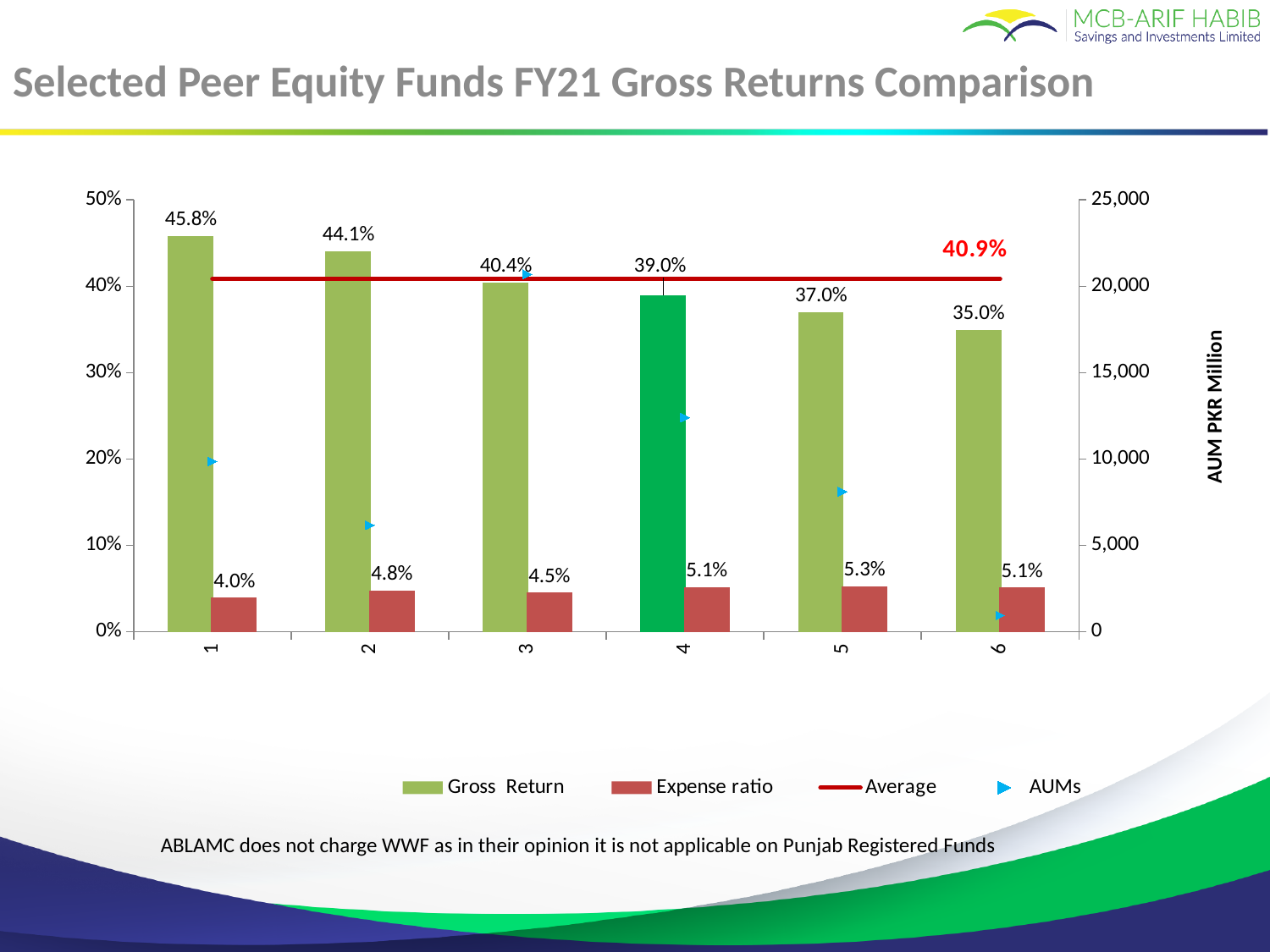
What is the difference between the Gross Return of fund 1 and fund 6? 10.8% How many funds are shown on the x axis? 6 Is the AUMs value for fund 3 greater or less than 15,000? greater Which is larger, the Expense ratio of fund 2 or fund 3? fund 2 Which fund has the lowest Expense ratio? 1 Do the Gross Return values rise or fall from fund 1 to fund 6? fall What is the Expense ratio for fund 5? 5.3% What value does the Average line show? 40.9% What is the Gross Return for fund 1? 45.8% Which fund has the highest Gross Return? 1 How many series does the legend list? 4 Is the AUMs value for fund 6 greater or less than 5,000? less